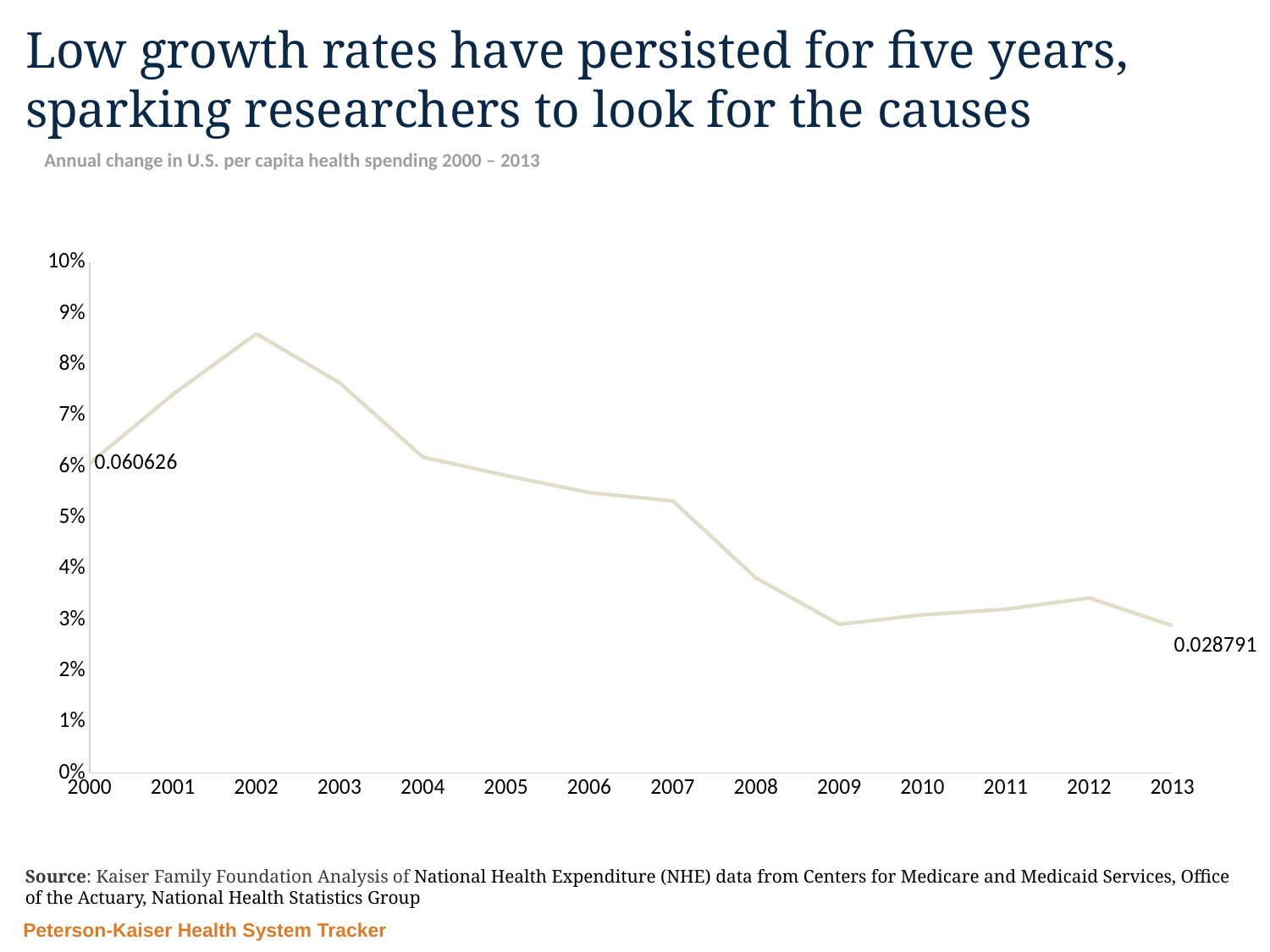
Which year has the highest annual change in per capita health spending? 2002 What is the difference between the labelled values for 2000 and 2013? 0.031835 Is the value for 2002 greater or less than 8%? greater Between 2002 and 2009, do the values generally rise or fall? Fall How many years are plotted on the x axis? 14 What is the data label shown for the year 2000? 0.060626 What is the data label shown for the year 2013? 0.028791 Which year has the larger value, 2002 or 2013? 2002 What kind of chart is shown on the slide? Line chart What is the subtitle describing the chart's data? Annual change in U.S. per capita health spending 2000 – 2013 Is the value for 2003 greater or less than 7%? greater Is the value for 2008 greater or less than 5%? less